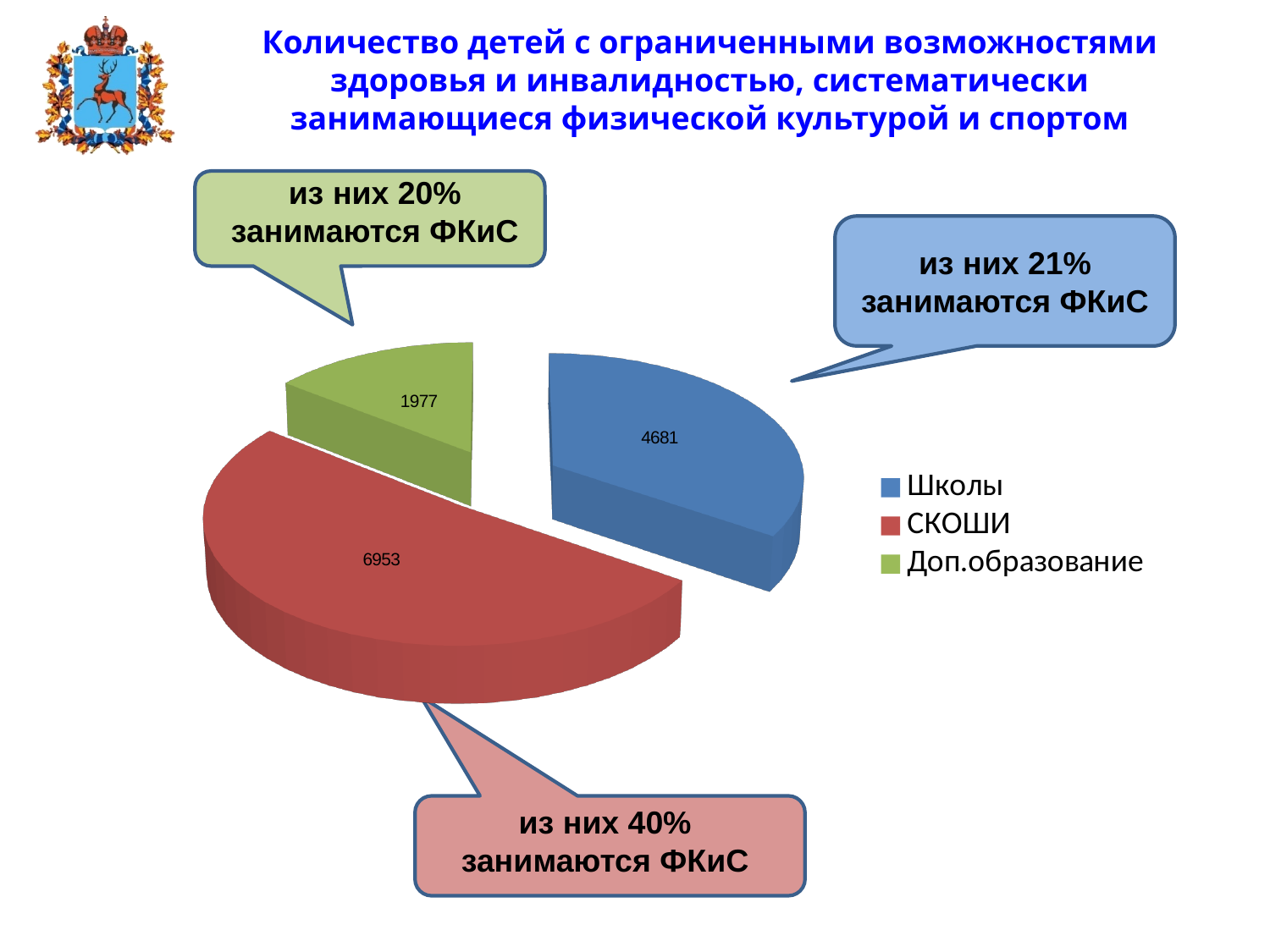
What is the value for СКОШИ in the pie chart? 6953 What is the difference between the values for СКОШИ and Школы? 2272 What is the value for Доп.образование in the pie chart? 1977 What colour is the СКОШИ slice in the pie chart? Red Which category has the smallest slice of the pie chart? Доп.образование What is the value for Школы in the pie chart? 4681 What is the total of all three slices in the pie chart? 13611 What is the difference between the values for Школы and Доп.образование? 2704 Which category has the largest slice of the pie chart? СКОШИ What kind of chart is shown on the slide? Pie chart How many categories are shown in the pie chart? 3 Which is larger, the value for Школы or the value for Доп.образование? Школы